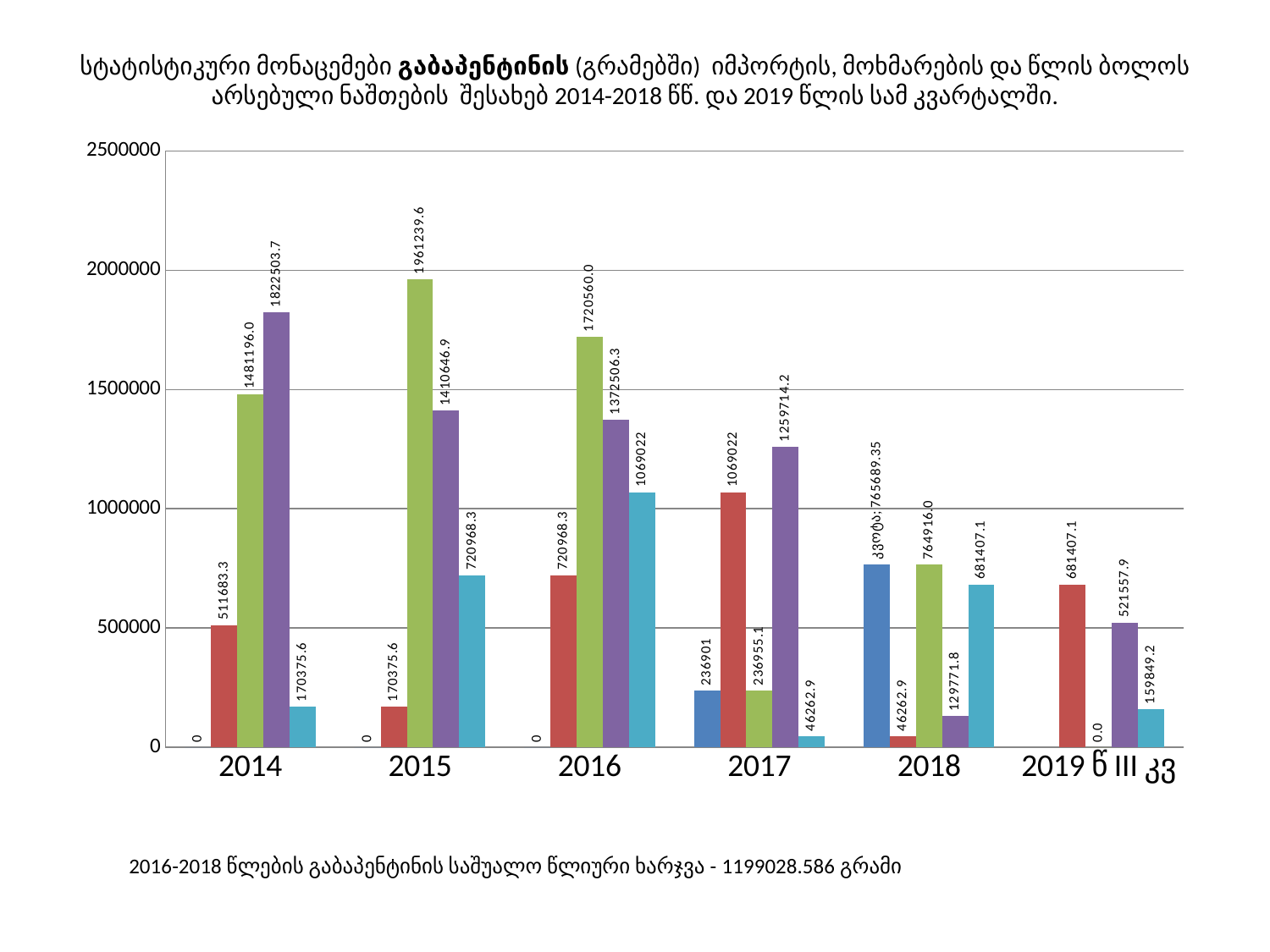
What is the difference between the green bar for 2016 and the purple bar for 2016? 348053.7 What is the value of the red bar for 2017? 1069022 How many categories are shown on the x axis? 6 Which year has the highest green bar? 2015 What is the value of the purple bar for 2019 წ III კვ? 521557.9 What is the value of the teal (light blue) bar for 2018? 681407.1 Which is larger: the red bar for 2016 or the red bar for 2014? the red bar for 2016 Is the value of the purple bar for 2017 greater or less than 1000000? greater What kind of chart is shown on the slide? bar chart Which year has the lowest purple bar? 2018 What is the value of the green bar for 2015? 1961239.6 What is the value of the purple bar for 2014? 1822503.7